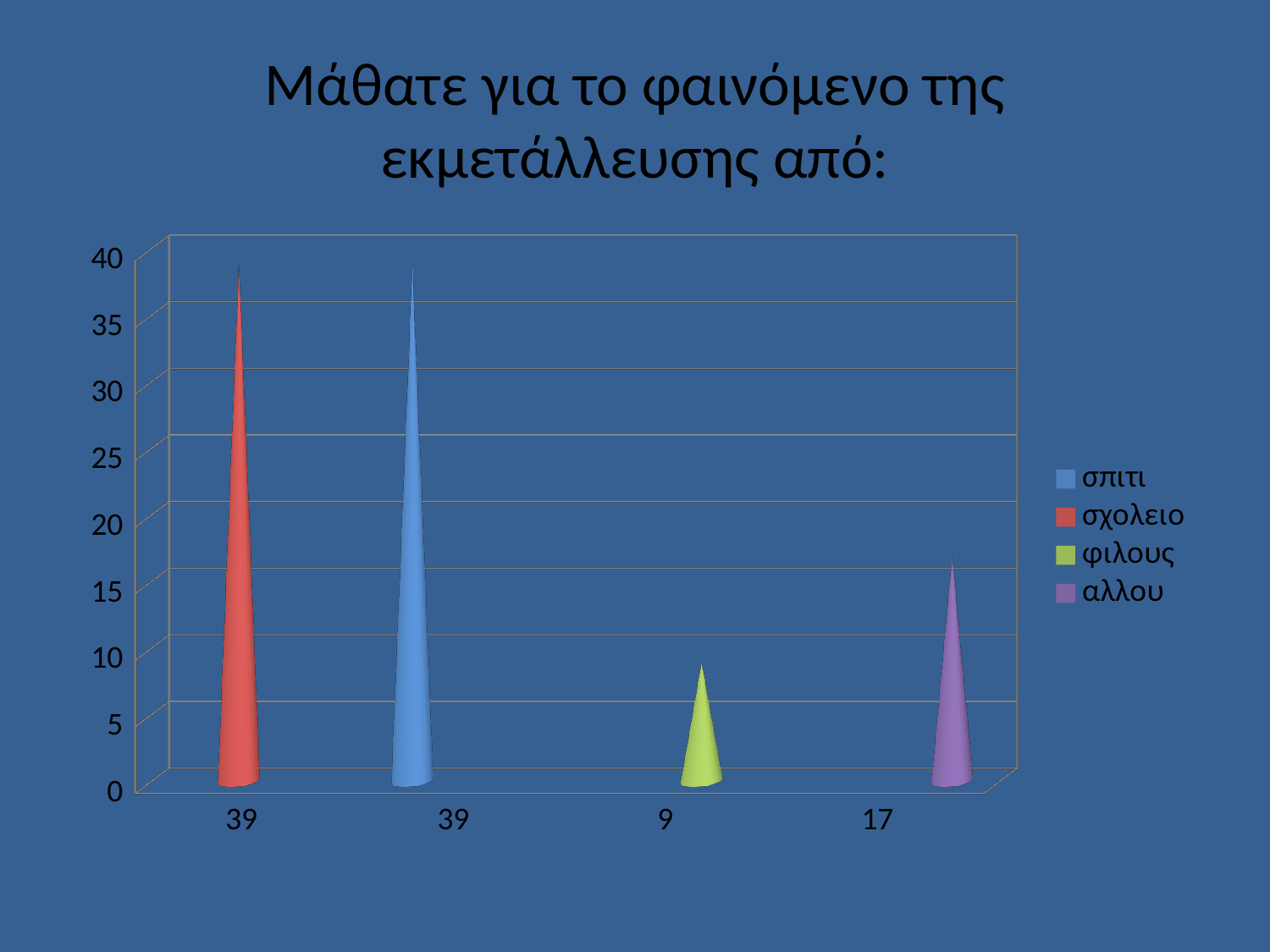
How many entries does the legend list? 4 What is the title of the chart on the slide? Μάθατε για το φαινόμενο της εκμετάλλευσης από: What is the difference between the value for αλλου and the value for φιλους? 8 What is the value for φιλους (the green bar)? 9 Which is larger, the value for αλλου or the value for φιλους? αλλου Which legend entry is shown in purple? αλλου Is the value for σχολειο (the red bar) greater or less than 30? greater What type of chart is shown on the slide? bar chart How many bars are plotted in the chart? 4 Is the value for αλλου (the purple bar) greater or less than 20? less What is the value for αλλου (the purple bar)? 17 Which category has the lowest value? φιλους